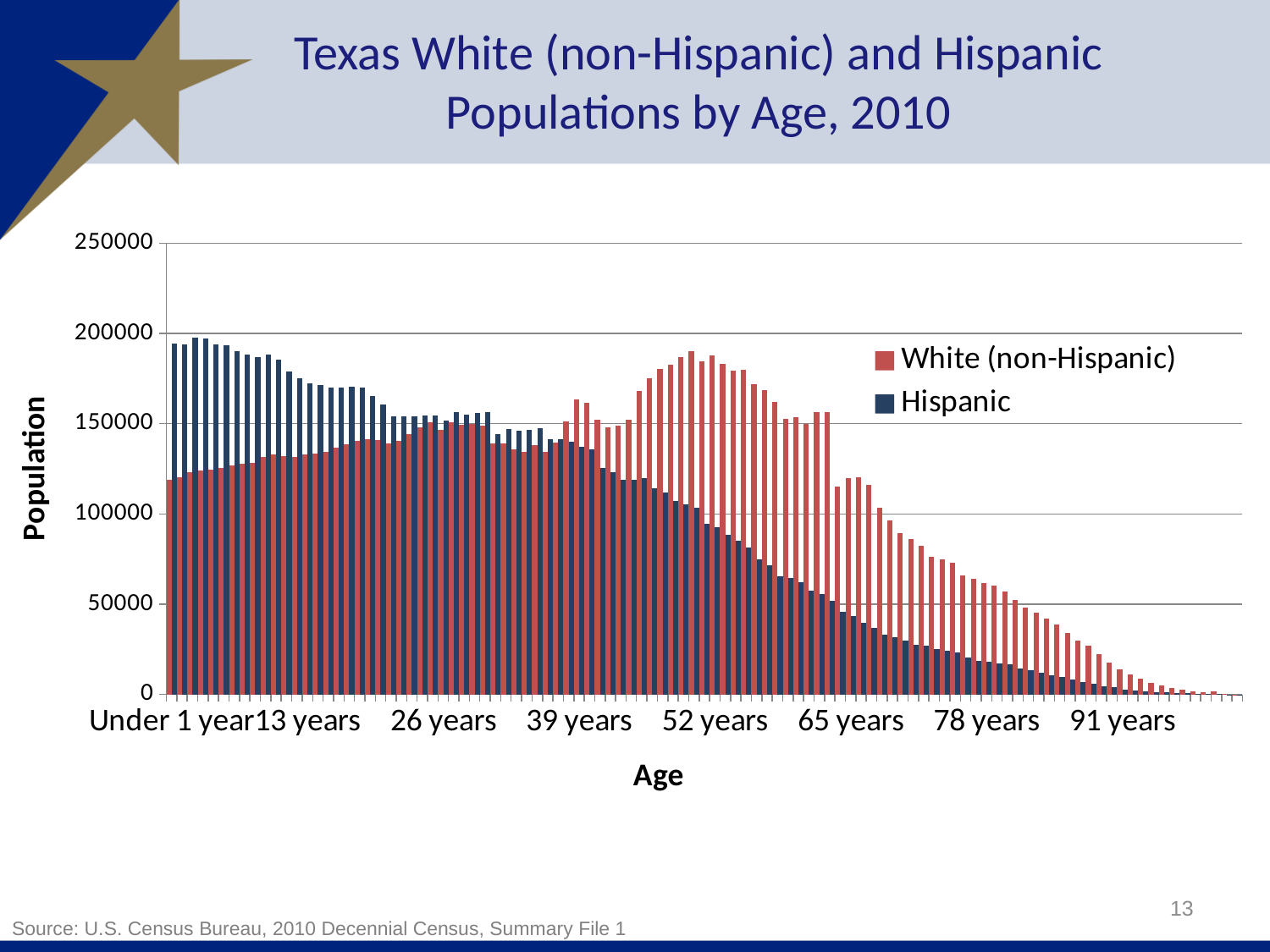
Is the White (non-Hispanic) population for Under 1 year greater or less than 150000? less At Under 1 year, which is larger: the Hispanic population or the White (non-Hispanic) population? Hispanic Is the Hispanic population at 78 years greater or less than 50000? less Is the White (non-Hispanic) population at 52 years greater or less than 150000? greater What kind of chart is shown on the slide? Bar chart What is the title of the chart? Texas White (non-Hispanic) and Hispanic Populations by Age, 2010 Which series is shown in red? White (non-Hispanic) From 52 years to 91 years, do the White (non-Hispanic) values rise or fall along the x axis? fall At 52 years, which is larger: the White (non-Hispanic) population or the Hispanic population? White (non-Hispanic) How many series does the legend list? 2